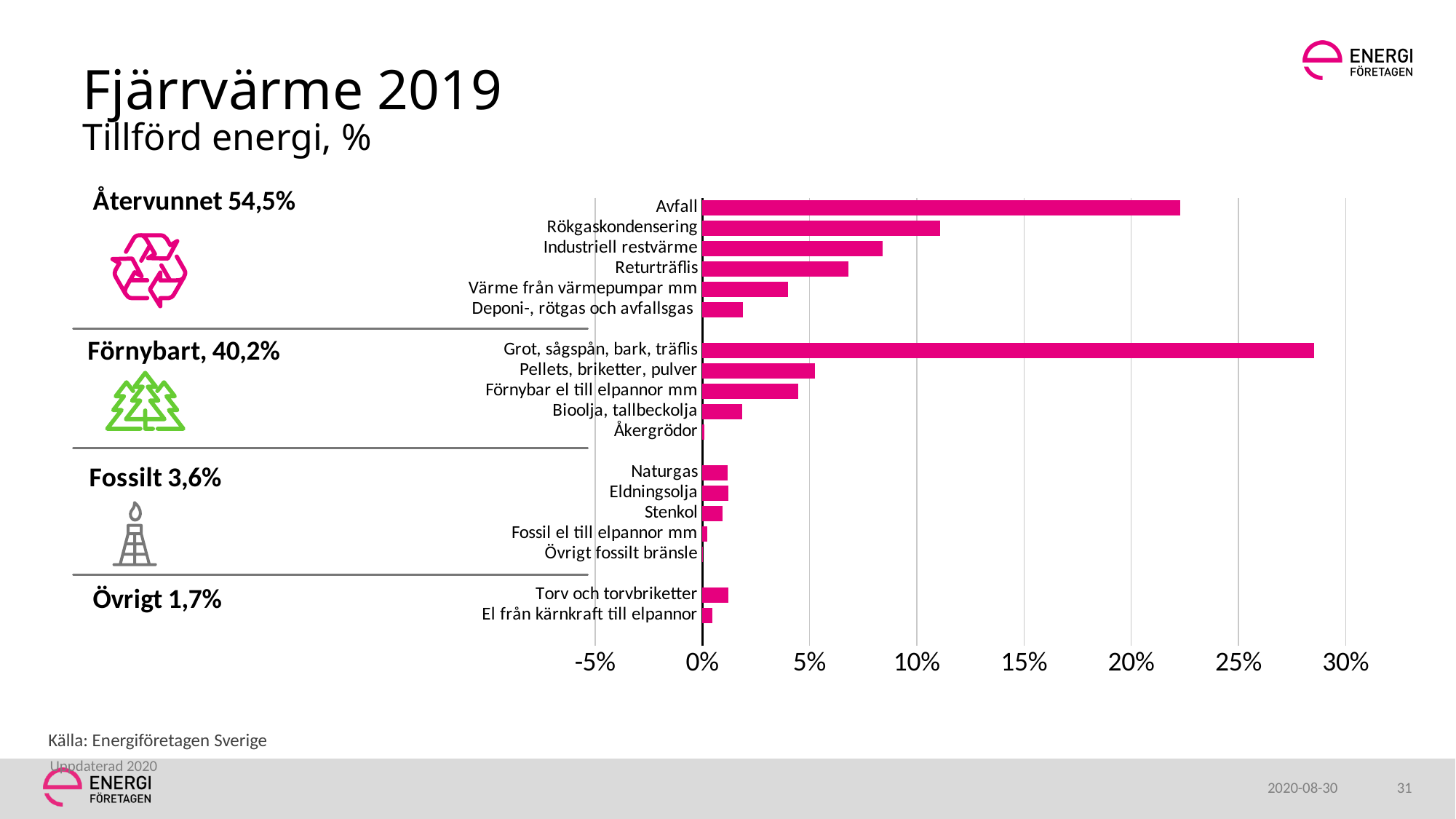
What kind of chart is shown on the slide? bar chart What is the title of the slide containing the chart? Fjärrvärme 2019 Which category has the lowest value in the chart? Övrigt fossilt bränsle Is the value for Avfall greater or less than 20%? greater Which category has the highest value in the chart? Grot, sågspån, bark, träflis Which is larger, the value for Avfall or the value for Rökgaskondensering? Avfall Is the value for Värme från värmepumpar mm greater or less than 5%? less Is the value for Grot, sågspån, bark, träflis greater or less than 25%? greater How many categories (bars) does the chart list? 18 Which is larger, the value for Returträflis or the value for Naturgas? Returträflis